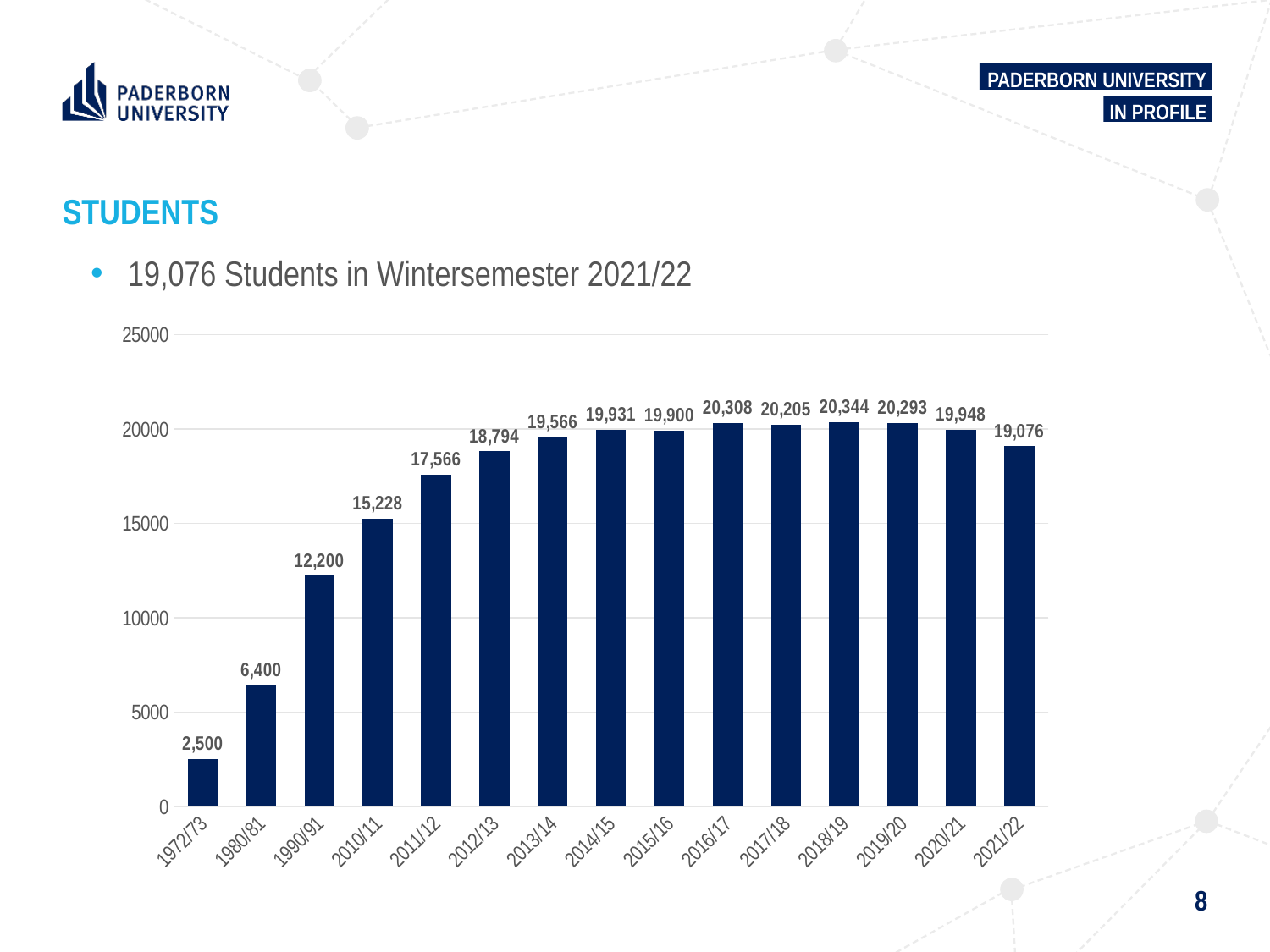
Which is larger, the value for 2016/17 or the value for 2017/18? 2016/17 How many students were there in 2021/22 according to the chart? 19,076 Do the values rise or fall from 1972/73 to 2018/19? rise What is the difference between the values for 1980/81 and 1972/73? 3,900 Which year has the lowest number of students? 1972/73 What is the value shown for 1990/91? 12,200 What is the value shown for 2016/17? 20,308 What kind of chart is shown on the slide? bar chart How many years (bars) are shown in the chart? 15 Which year has the highest number of students? 2018/19 What is the difference between the values for 2020/21 and 2021/22? 872 Is the value for 1990/91 greater or less than 10000? greater